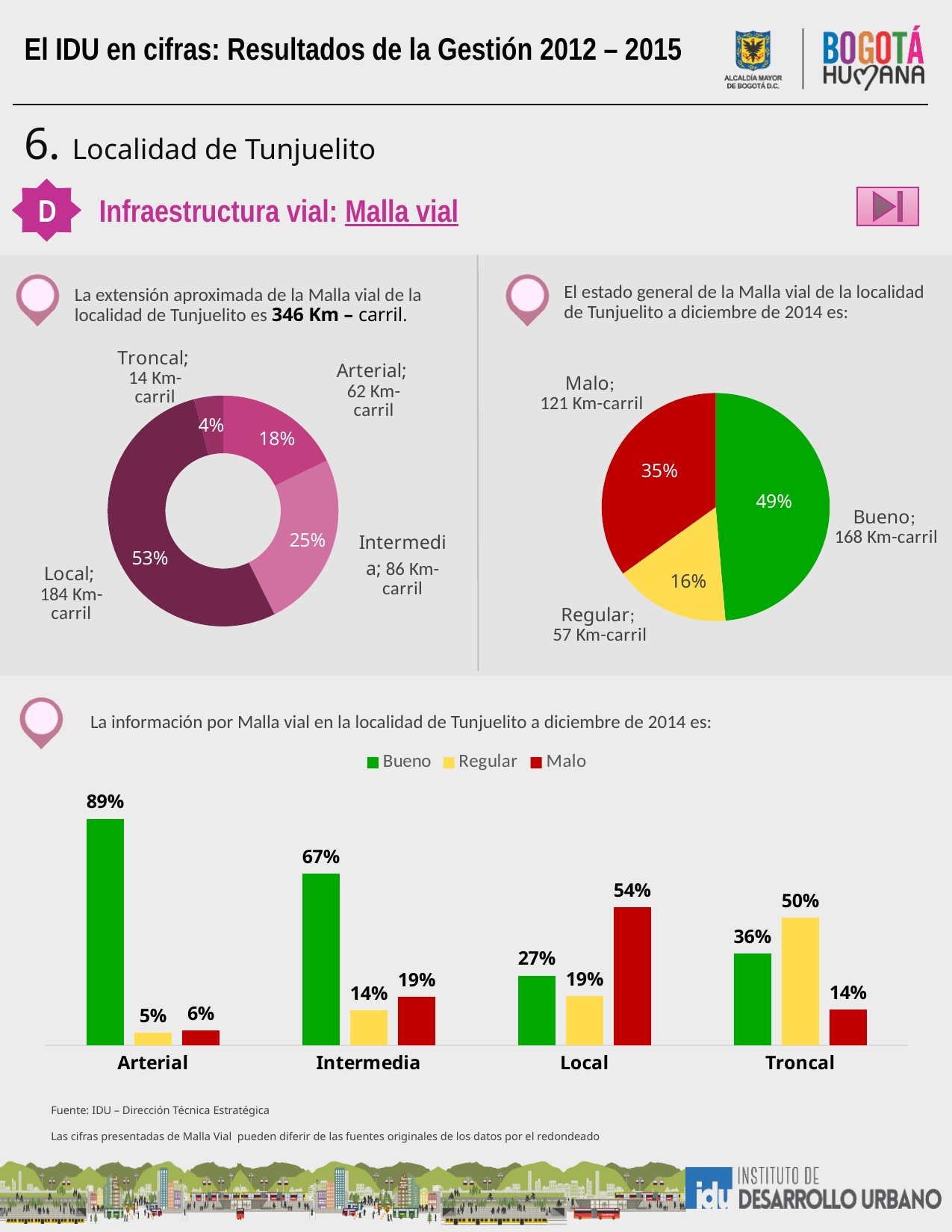
In the pie chart on the right, what is the difference in percentage points between Bueno and Regular? 33 In the bar chart at the bottom, what is the Malo value for Local? 54% In the pie chart on the right, what percentage of the road network is in Malo condition? 35% In the bar chart at the bottom, what is the Bueno value for Arterial? 89% In the bar chart at the bottom, is the Bueno value for Intermedia larger or smaller than the Bueno value for Troncal? larger In the bar chart at the bottom, which category has the highest Regular value? Troncal In the pie chart on the right, how many Km-carril are in Bueno condition? 168 Km-carril In the donut chart on the left, how many Km-carril does Arterial account for? 62 Km-carril In the bar chart at the bottom, how many series does the legend list? 3 In the donut chart on the left, how many categories are shown? 4 In the donut chart on the left, which category has the smallest share? Troncal In the donut chart on the left, what percentage share does Local have? 53%